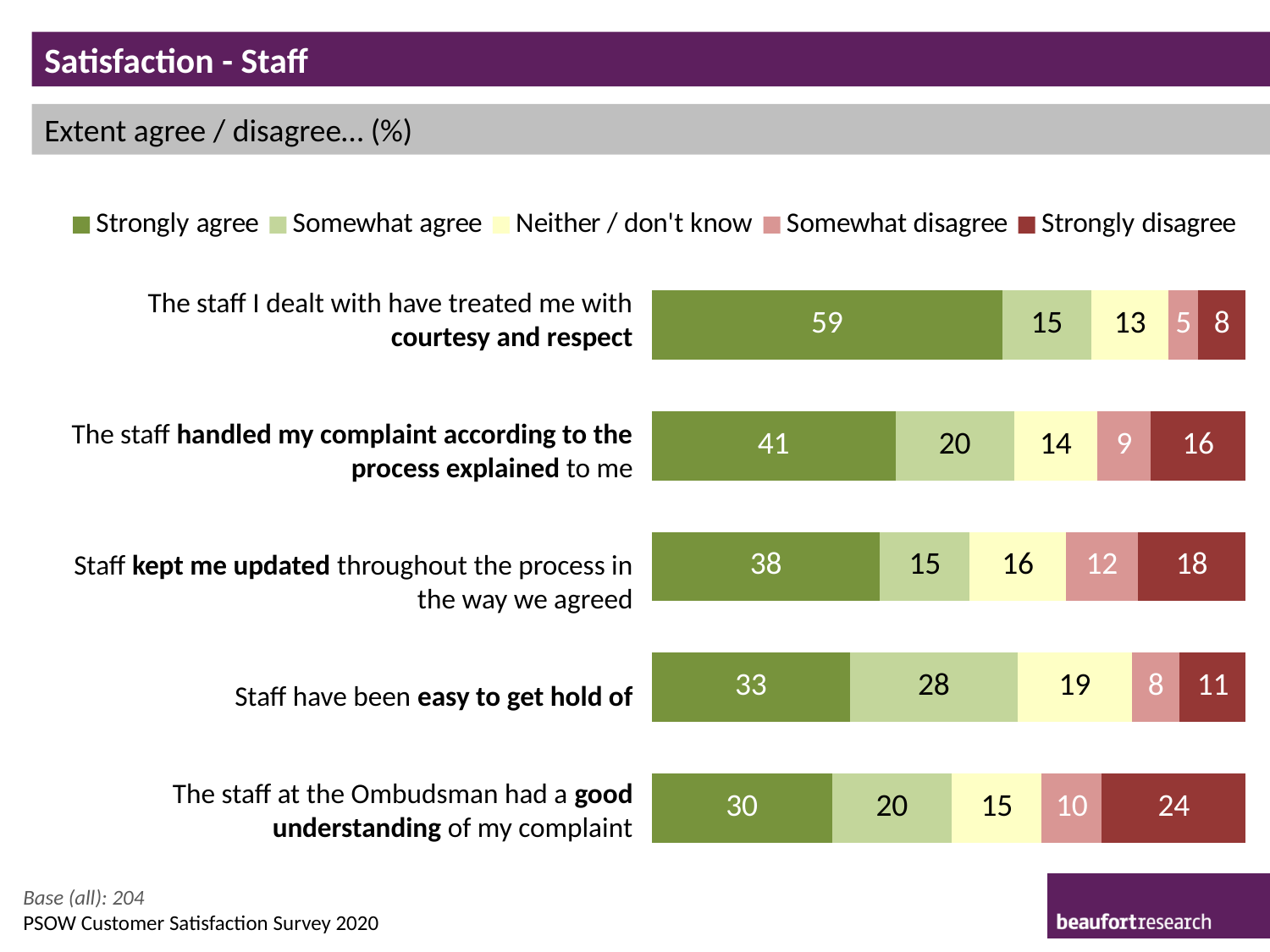
How many statements are shown in the chart? 5 What percentage strongly agree that the staff they dealt with treated them with courtesy and respect? 59 Which statement has the highest 'Strongly agree' percentage? The staff I dealt with have treated me with courtesy and respect What is the 'Neither / don't know' value for 'Staff have been easy to get hold of'? 19 How many response categories does the legend list? 5 What is the total of the printed values for 'Staff kept me updated throughout the process in the way we agreed'? 99 What percentage strongly disagree that the staff at the Ombudsman had a good understanding of their complaint? 24 What type of chart is shown on the slide? Stacked bar chart Which legend entry is shown in dark red? Strongly disagree How much higher is the 'Strongly agree' value for 'courtesy and respect' than for 'handled my complaint according to the process explained'? 18 Which statement has the lowest 'Strongly agree' percentage? The staff at the Ombudsman had a good understanding of my complaint Which has a larger 'Somewhat agree' value: 'Staff have been easy to get hold of' or 'Staff kept me updated throughout the process'? Staff have been easy to get hold of